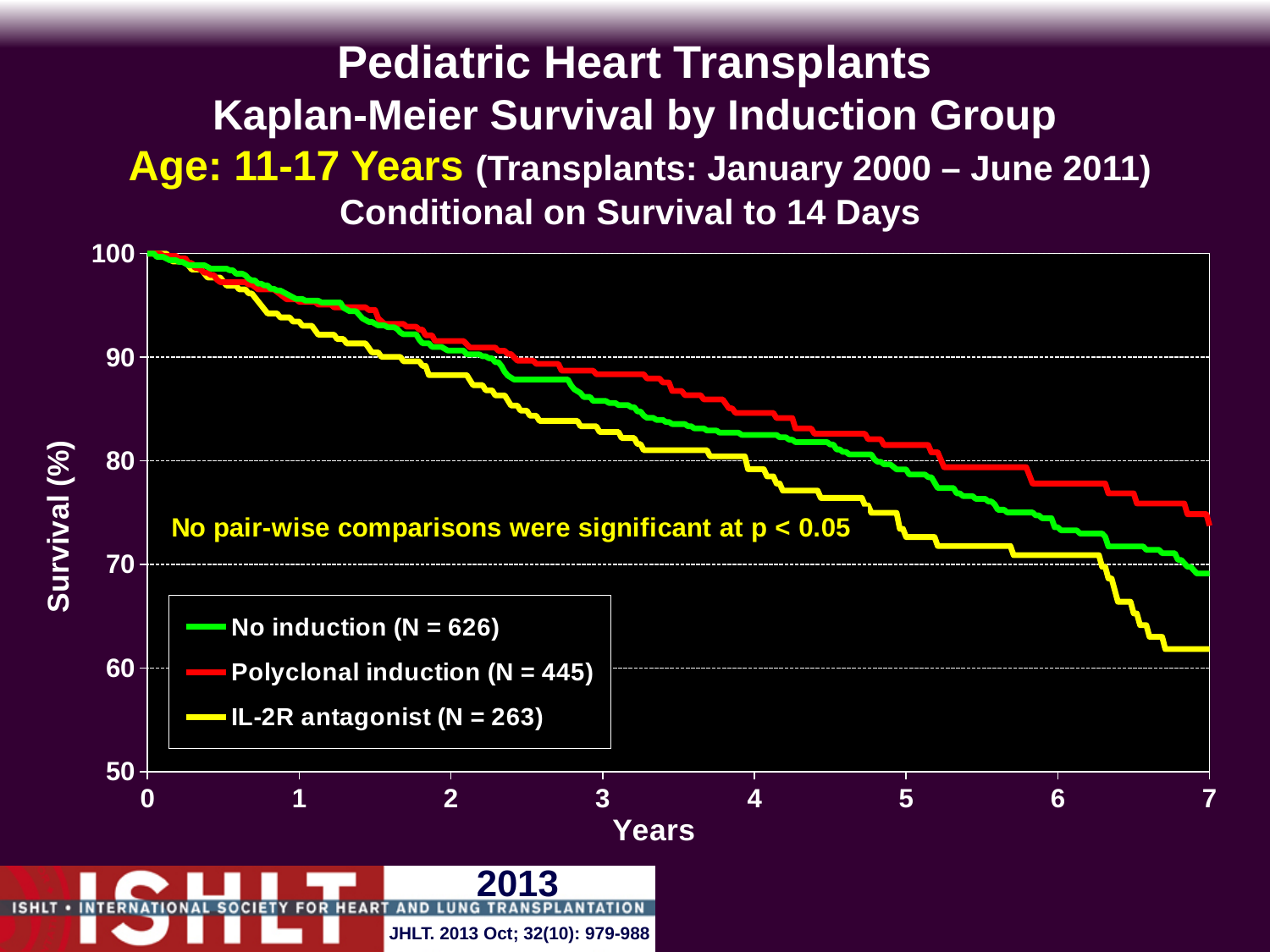
At 6.5 years, which group has higher survival: Polyclonal induction or IL-2R antagonist? Polyclonal induction What is the N for the No induction group shown in the legend? 626 Is the survival for IL-2R antagonist at 3 years greater or less than 80? greater Is the survival for IL-2R antagonist at 7 years greater or less than 70? less Which induction group has the lowest survival at 7 years? IL-2R antagonist Is the survival for Polyclonal induction at 7 years greater or less than 70? greater What kind of chart is shown on the slide? Line chart Do the survival curves rise or fall as years increase? Fall How many series does the legend list? 3 What is the label of the y axis? Survival (%) Which induction group has the highest survival at 7 years? Polyclonal induction